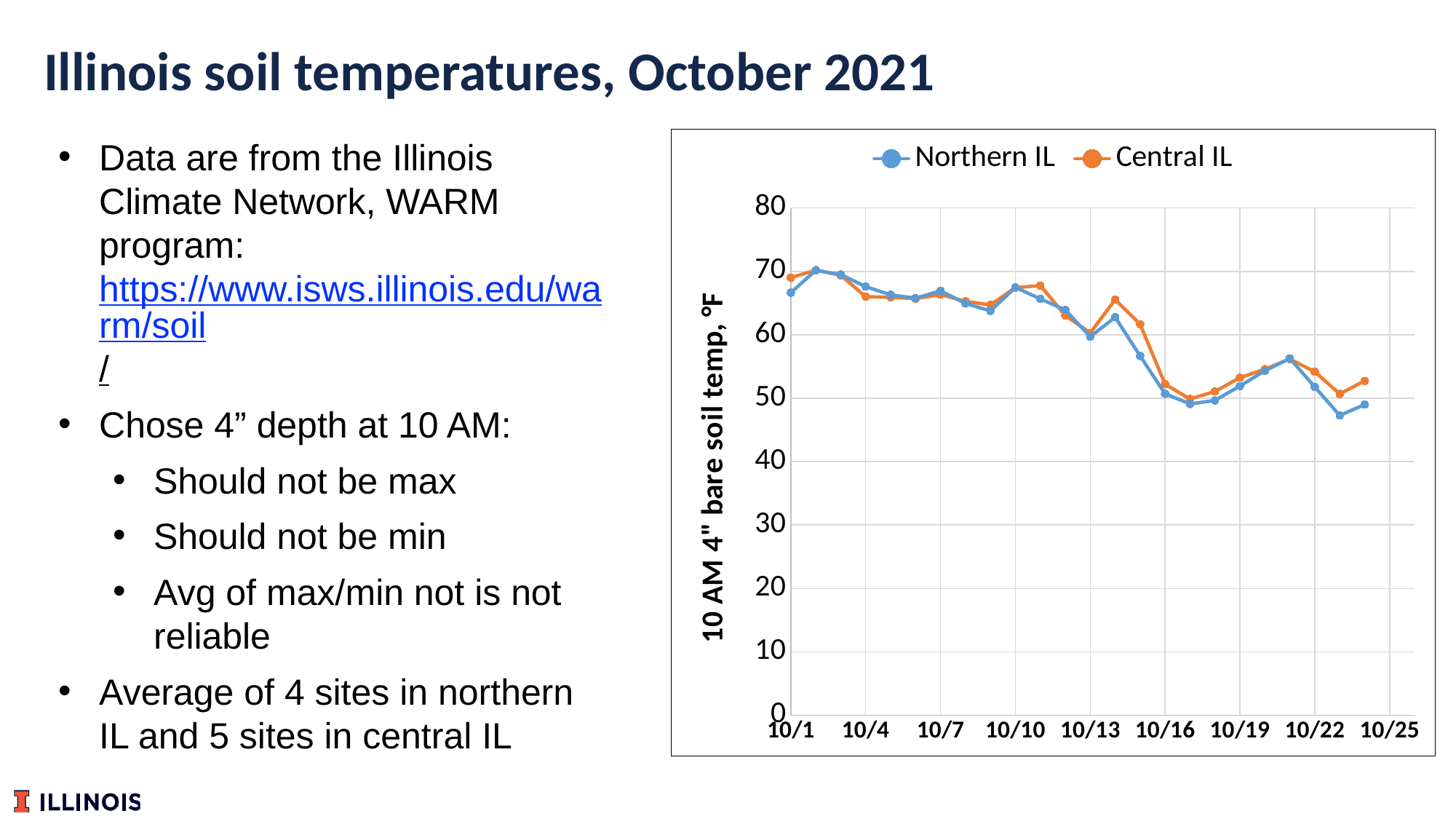
What kind of chart is shown on the slide? line chart Is the Central IL value on 10/14 greater or less than 60? greater What are the two series named in the chart legend? Northern IL and Central IL On 10/15, which series has the higher value, Northern IL or Central IL? Central IL What is the label on the vertical axis of the chart? 10 AM 4" bare soil temp, °F Is the Northern IL value on 10/10 greater or less than 60? greater Is the Northern IL value on 10/23 greater or less than 50? less How many date labels are shown on the x axis? 9 Overall, do the soil temperatures rise or fall from 10/1 to the end of the period shown? fall On 10/23, which series has the higher value, Northern IL or Central IL? Central IL How many series does the chart legend list? 2